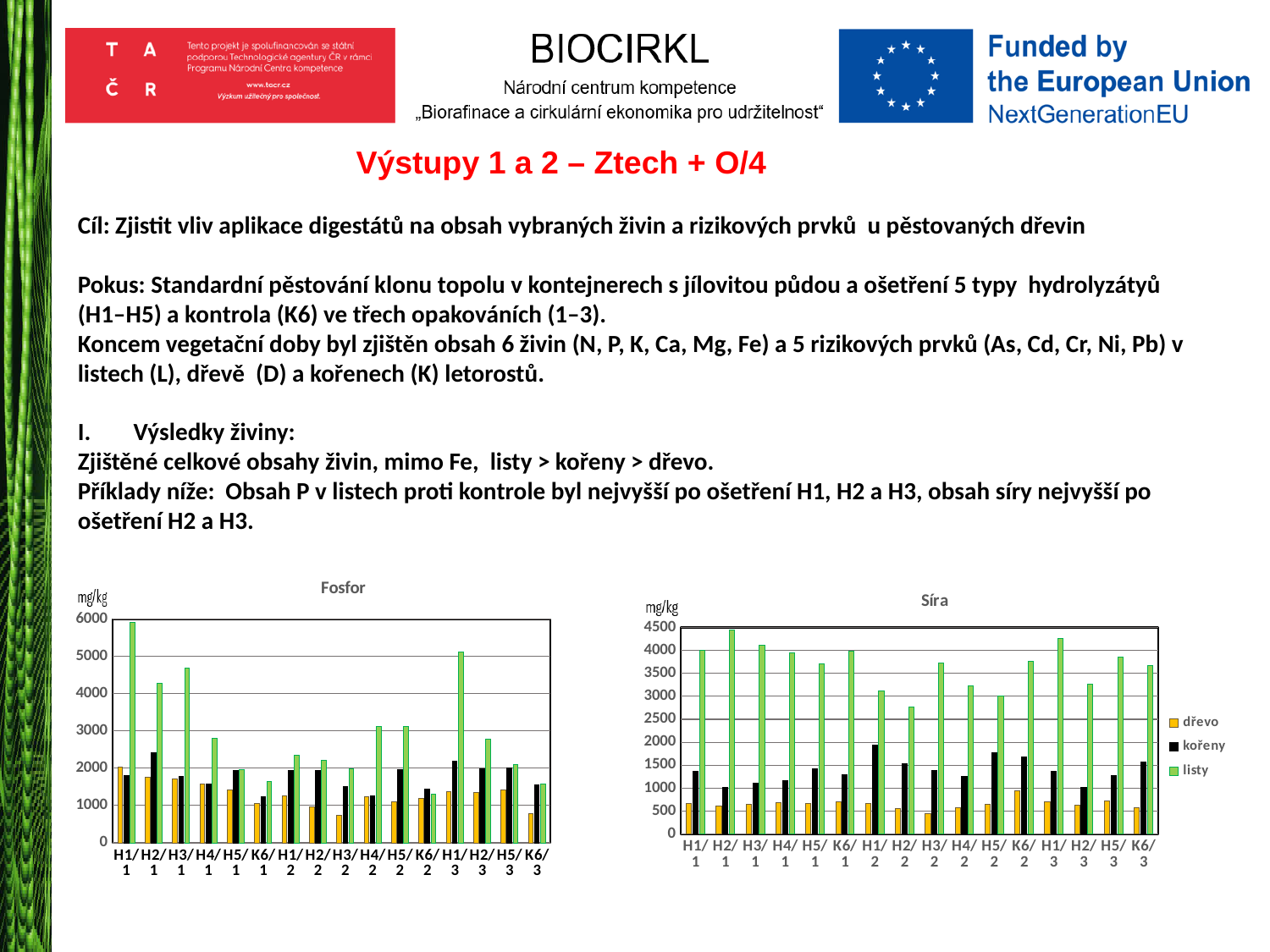
How many series does the legend of the 'Síra' chart list? 3 In the 'Fosfor' chart, is the green (listy) bar for H1/1 larger or smaller than the green bar for H2/1? larger In the 'Síra' chart, is the value of the listy bar for H2/1 greater or less than 4000? greater What are the legend entries on the 'Síra' chart? dřevo, kořeny, listy How many categories are shown on the x axis of the 'Fosfor' chart? 16 In the 'Fosfor' chart, is the value of the green (listy) bar for K6/1 greater or less than 2000? less In the 'Fosfor' chart, is the value of the green (listy) bar for H1/1 greater or less than 5000? greater What unit is shown on the y axis of the 'Síra' chart? mg/kg What kind of chart is the 'Fosfor' chart? bar chart In the 'Fosfor' chart, which category has the highest green (listy) bar? H1/1 In the 'Síra' chart, which category has the lowest listy bar? H2/2